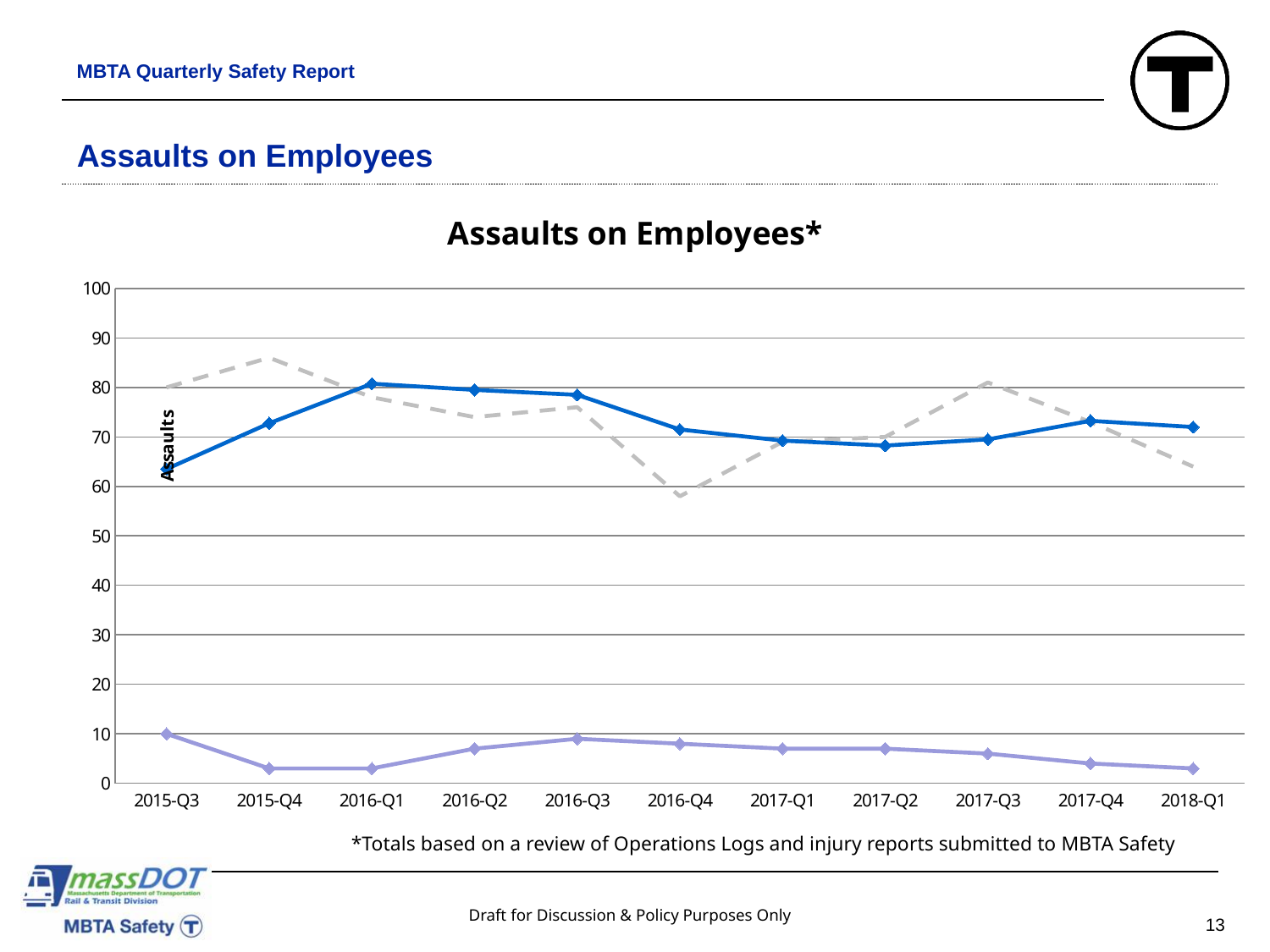
In which quarter does the solid blue line reach its highest value? 2016-Q1 Is the value of the light purple line for 2017-Q4 greater or less than 10? less Is the value of the gray dashed line for 2016-Q4 greater or less than 70? less How many lines are plotted on the chart? 3 Is the value of the solid blue line for 2016-Q1 greater or less than 70? greater In which quarter does the solid blue line have its lowest value? 2015-Q3 Does the solid blue line rise or fall from 2016-Q1 to 2017-Q2? fall What is the title of the chart? Assaults on Employees* What kind of chart is shown on the slide? line chart How many quarters are shown along the x axis of the chart? 11